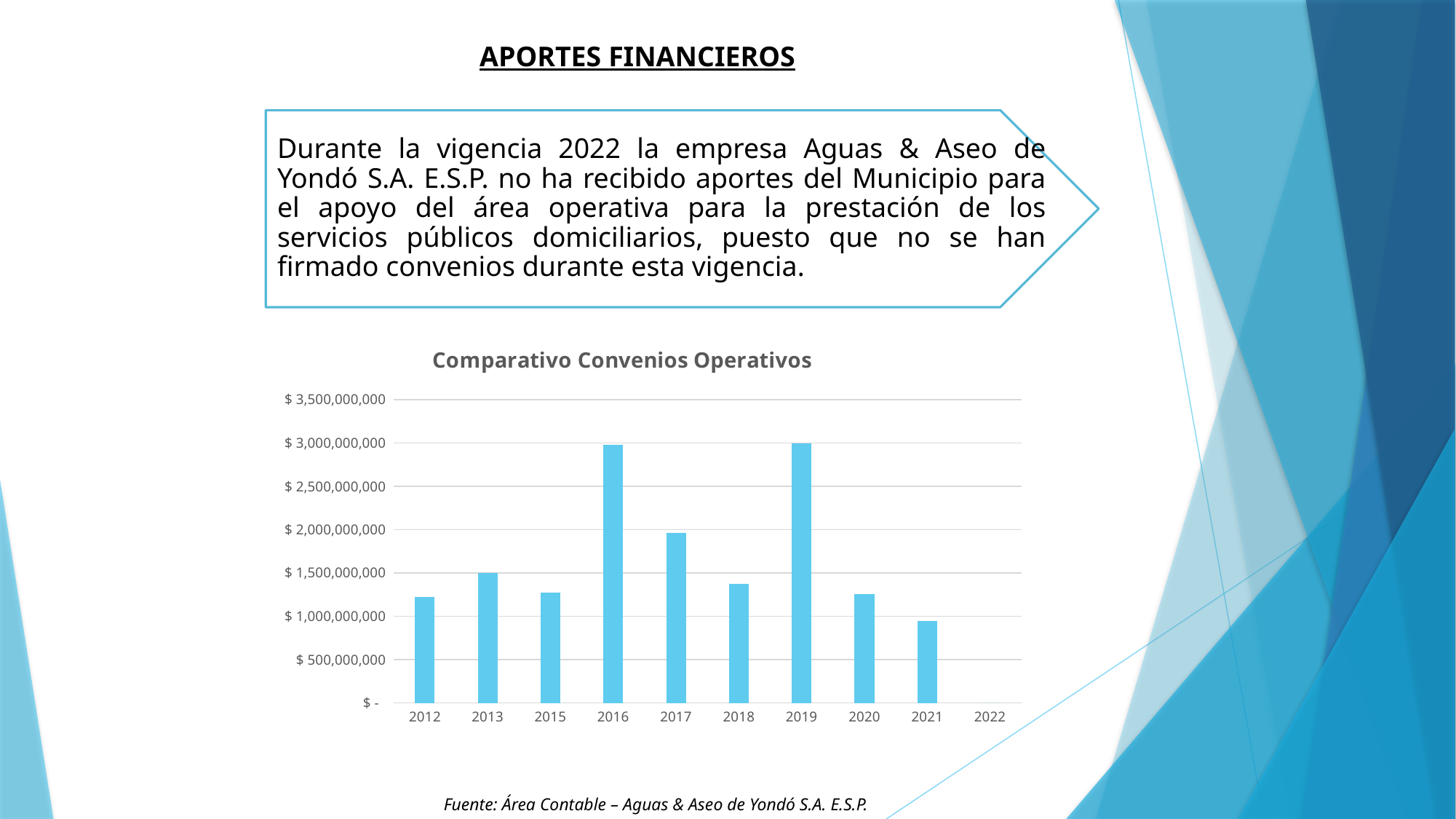
Which year has the larger value, 2017 or 2018? 2017 What type of chart is shown on the slide? bar chart Is the value for 2021 greater or less than $ 1,000,000,000? less Is the value for 2017 greater or less than $ 1,500,000,000? greater Which year has the larger value, 2012 or 2013? 2013 What is the title of the chart? Comparativo Convenios Operativos Is the value for 2018 greater or less than $ 1,500,000,000? less How many years are shown on the x axis of the chart? 10 Which year on the x axis has no bar at all? 2022 Among the years with a visible bar, which has the lowest value? 2021 Do the values rise or fall from 2019 to 2021? fall